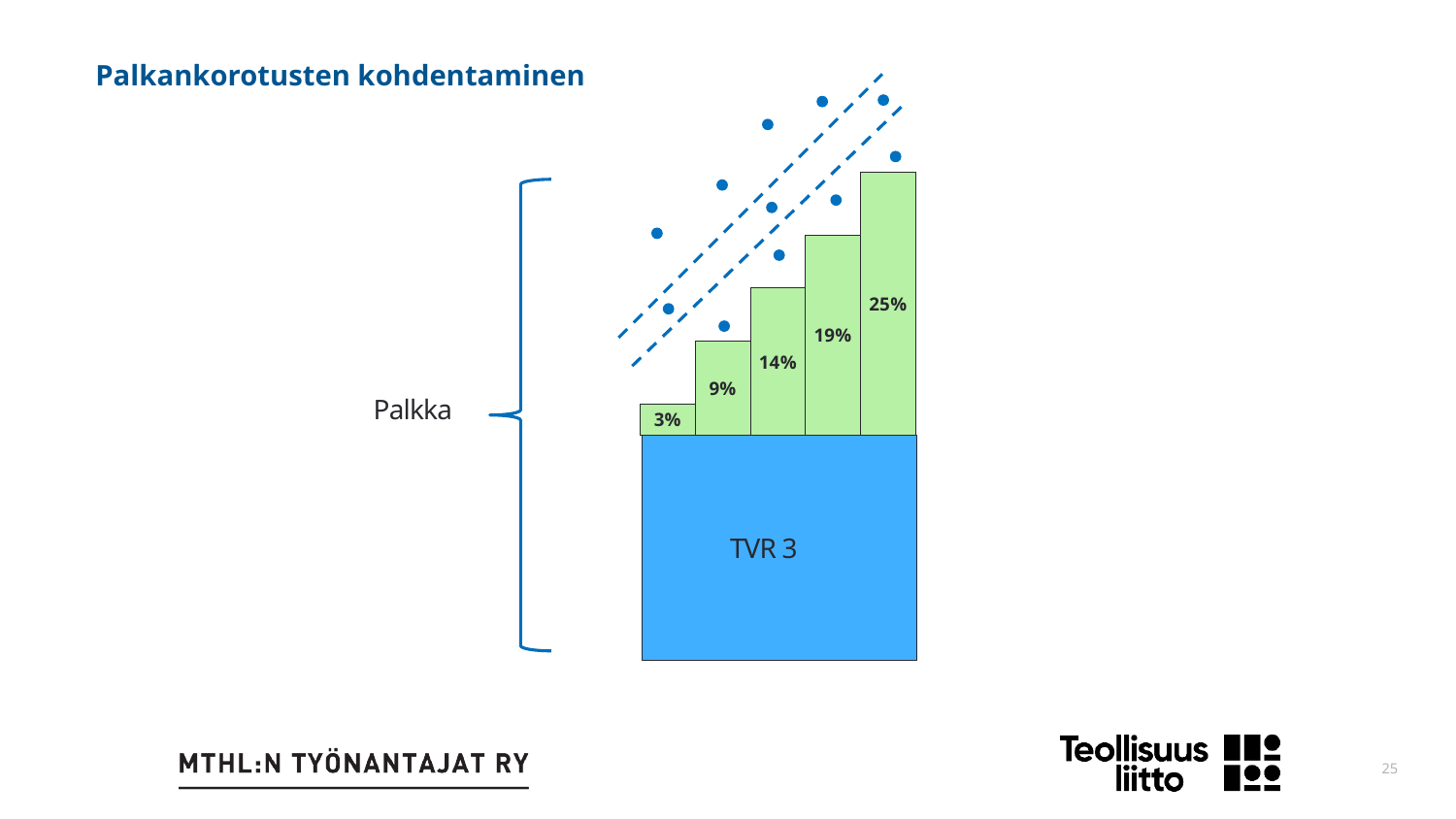
Which is larger, the second green bar or the fourth green bar? The fourth green bar (19%) What value is printed on the middle (third) green bar? 14% What value is printed on the rightmost green bar? 25% What is the difference between the fourth green bar (19%) and the second green bar (9%)? 10% Do the green bar values rise or fall from left to right? Rise What is the difference between the rightmost green bar (25%) and the leftmost green bar (3%)? 22% Which green bar has the highest value? The rightmost bar (25%) How many green bars are stacked on top of the blue TVR 3 block? 5 Which green bar has the lowest value? The leftmost bar (3%) What is the title of the chart on the slide? Palkankorotusten kohdentaminen What value is printed on the leftmost green bar? 3% What label is printed on the large blue block at the bottom of the chart? TVR 3